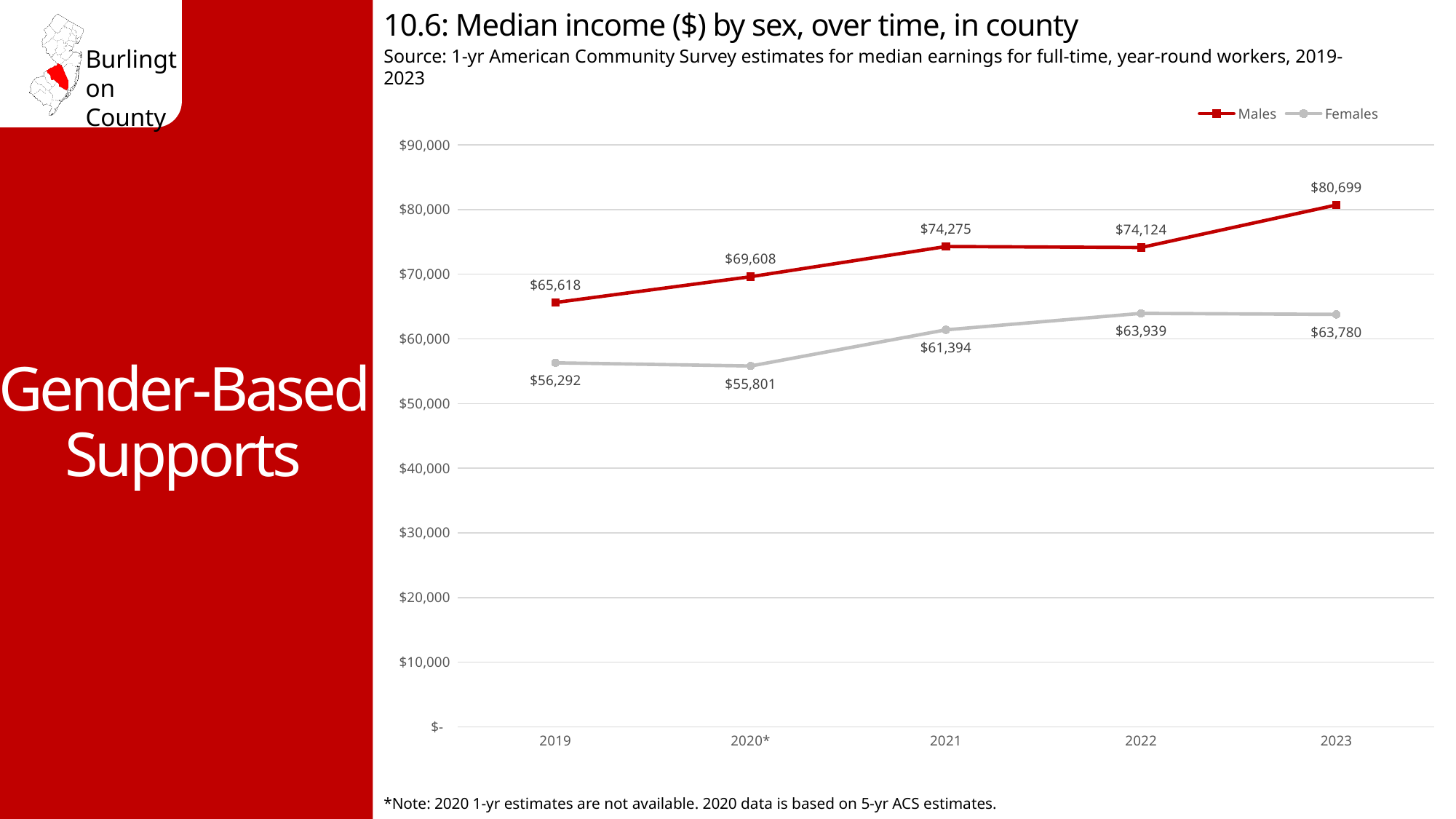
What was the median income for Females in 2020*? $55,801 In which year was the median income for Males highest? 2023 Did the median income for Males generally rise or fall from 2019 to 2023? Rise How many series does the legend list? 2 What kind of chart is shown on the slide? Line chart What was the median income for Males in 2021? $74,275 What was the median income for Males in 2023? $80,699 Which was larger in 2022, the median income for Males or for Females? Males How many years are shown on the x axis? 5 What was the median income for Females in 2019? $56,292 In which year was the median income for Females lowest? 2020* What is the difference between the Males and Females median income in 2023? $16,919